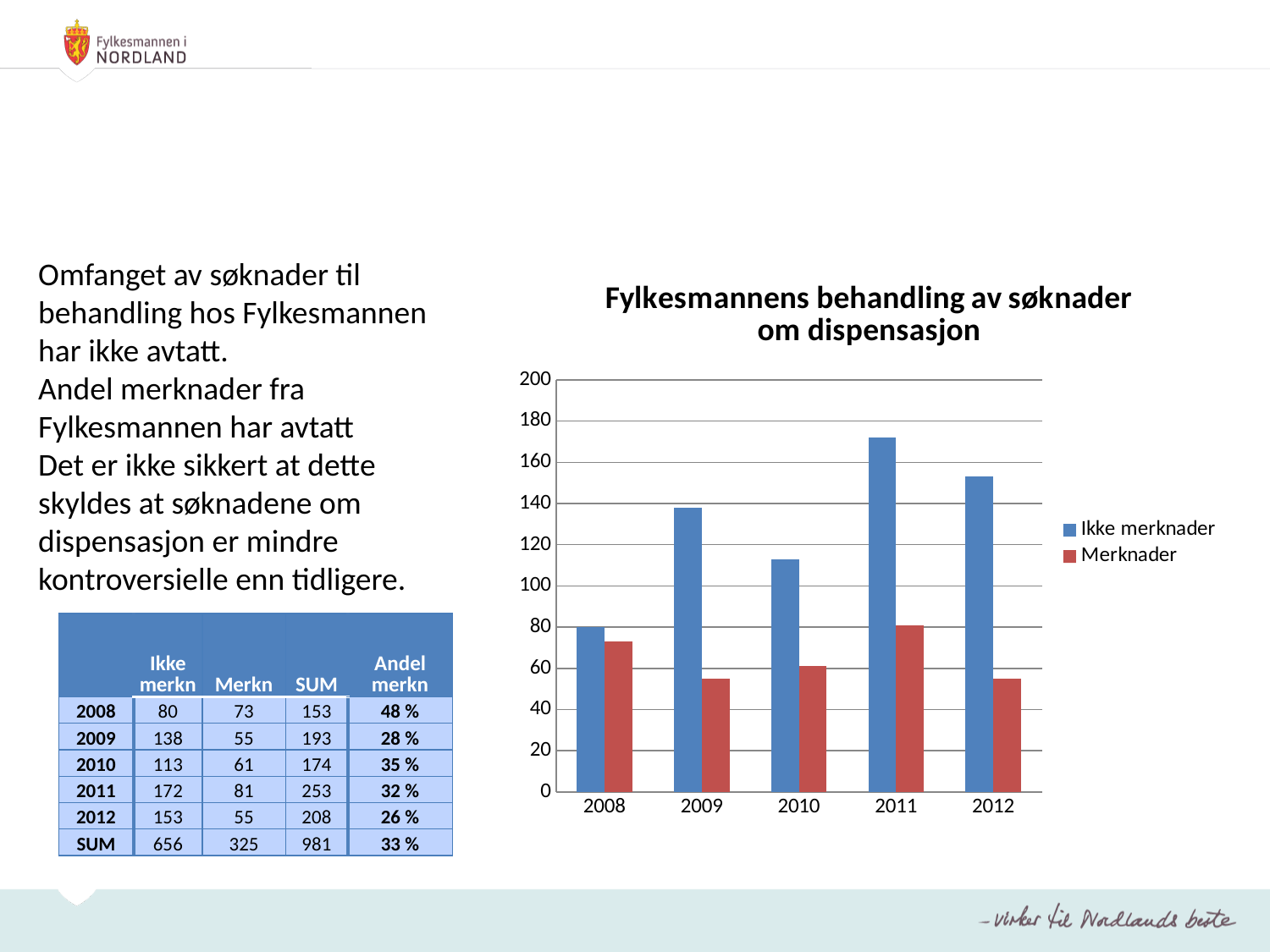
How many series does the chart legend list? 2 In which year is the Merknader bar highest? 2011 In which year is the Ikke merknader bar highest? 2011 What is the value of Ikke merknader for 2008? 80 How many years are shown on the x axis of the chart? 5 What is the title of the chart? Fylkesmannens behandling av søknader om dispensasjon Which is larger in 2010, Ikke merknader or Merknader? Ikke merknader What kind of chart is shown on the slide? bar chart Is the value of Ikke merknader for 2011 greater or less than 160? greater Does the Ikke merknader value rise or fall from 2011 to 2012? fall Is the value of Merknader for 2009 greater or less than 60? less In which year is the Ikke merknader bar lowest? 2008